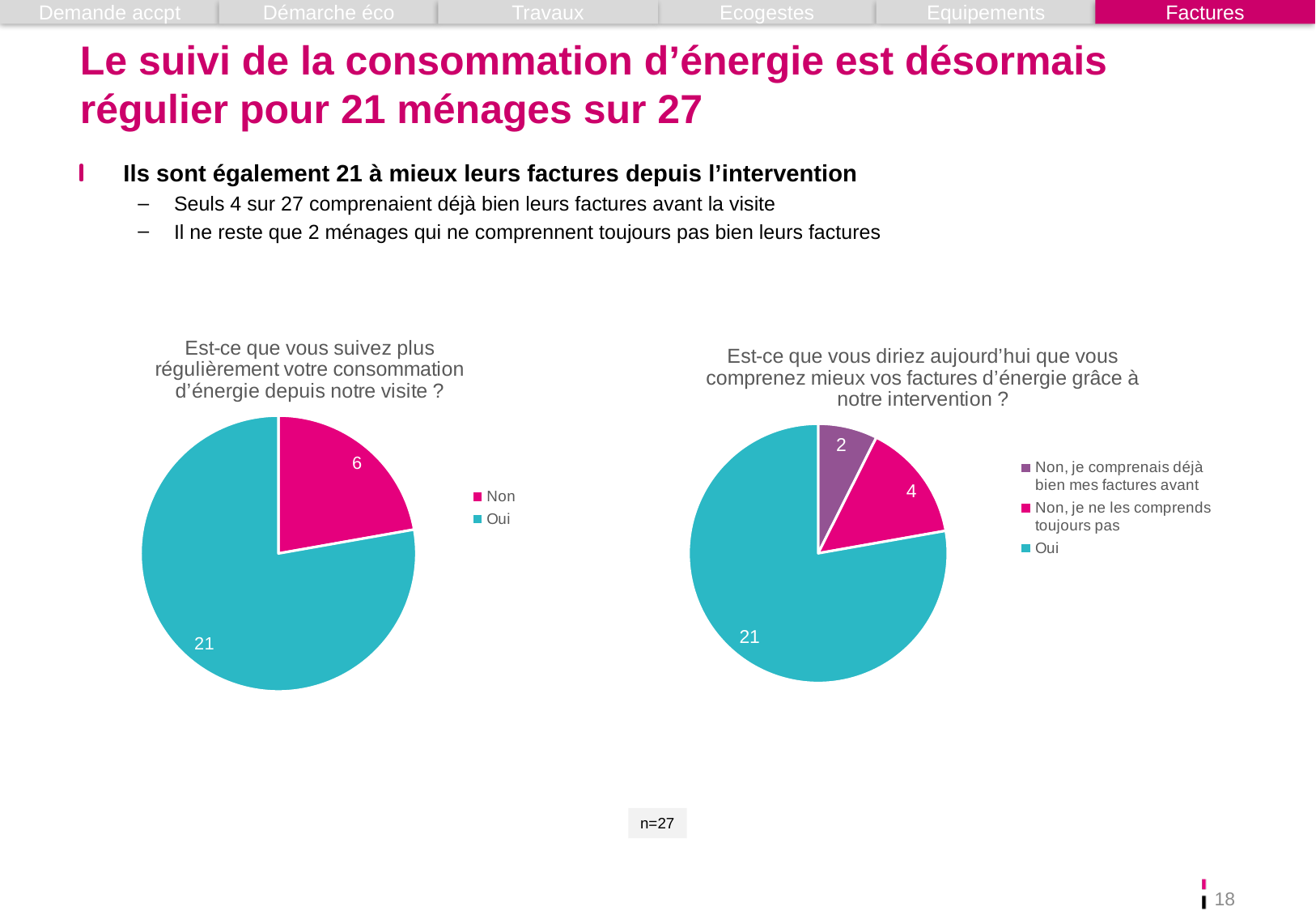
In the right pie chart, which category has the smallest slice? Non, je comprenais déjà bien mes factures avant In the right pie chart, which category has the largest slice? Oui How many slices does the right pie chart have? 3 How many entries does the legend of the left pie chart list? 2 In the right pie chart, which is larger: 'Non, je ne les comprends toujours pas' or 'Non, je comprenais déjà bien mes factures avant'? Non, je ne les comprends toujours pas In the left pie chart, what is the difference between the Oui and Non values? 15 What type of chart is used on the left of the slide? Pie chart In the right pie chart (Est-ce que vous diriez aujourd'hui que vous comprenez mieux vos factures d'énergie grâce à notre intervention ?), what is the value for 'Non, je ne les comprends toujours pas'? 4 In the left pie chart (Est-ce que vous suivez plus régulièrement votre consommation d'énergie depuis notre visite ?), what is the value for Oui? 21 In the right pie chart (Est-ce que vous diriez aujourd'hui que vous comprenez mieux vos factures d'énergie grâce à notre intervention ?), what is the value for 'Non, je comprenais déjà bien mes factures avant'? 2 In the left pie chart (Est-ce que vous suivez plus régulièrement votre consommation d'énergie depuis notre visite ?), what is the value for Non? 6